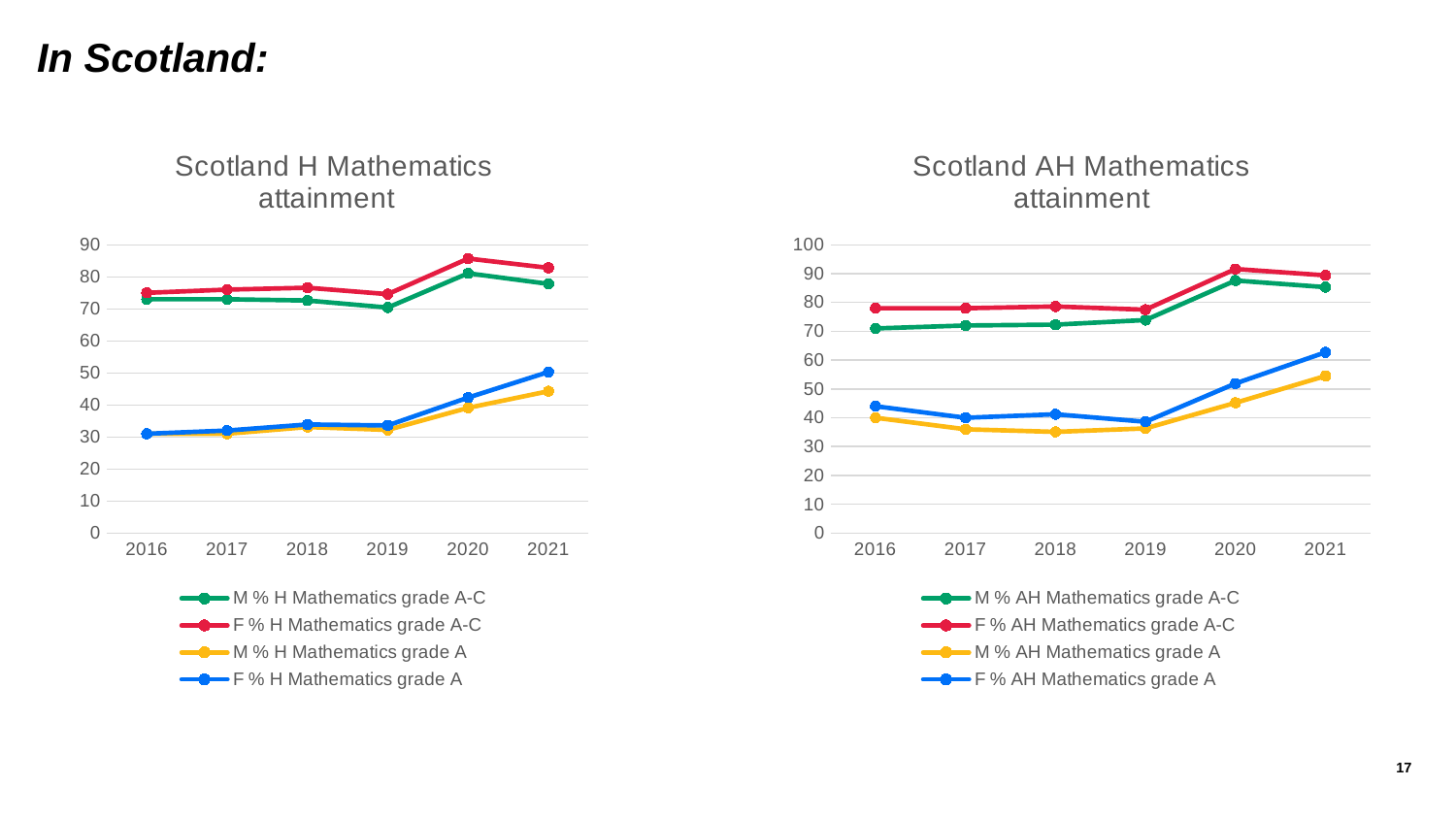
How many series does the legend of the 'Scotland AH Mathematics attainment' chart list? 4 In the 'Scotland AH Mathematics attainment' chart, is the value for M % AH Mathematics grade A in 2018 greater or less than 40? less In the 'Scotland AH Mathematics attainment' chart, is the value for F % AH Mathematics grade A in 2021 greater or less than 60? greater In the 'Scotland AH Mathematics attainment' chart, is the value for M % AH Mathematics grade A-C in 2016 greater or less than 80? less What kind of chart is the 'Scotland H Mathematics attainment' chart? line chart In the 'Scotland H Mathematics attainment' chart, in which year is F % H Mathematics grade A-C highest? 2020 In the 'Scotland AH Mathematics attainment' chart, does M % AH Mathematics grade A rise or fall from 2019 to 2021? rise How many years are shown on the x axis of the 'Scotland H Mathematics attainment' chart? 6 In the 'Scotland AH Mathematics attainment' chart, which colour is the line for F % AH Mathematics grade A-C? red In the 'Scotland H Mathematics attainment' chart, which is higher in 2021: F % H Mathematics grade A or M % H Mathematics grade A? F % H Mathematics grade A